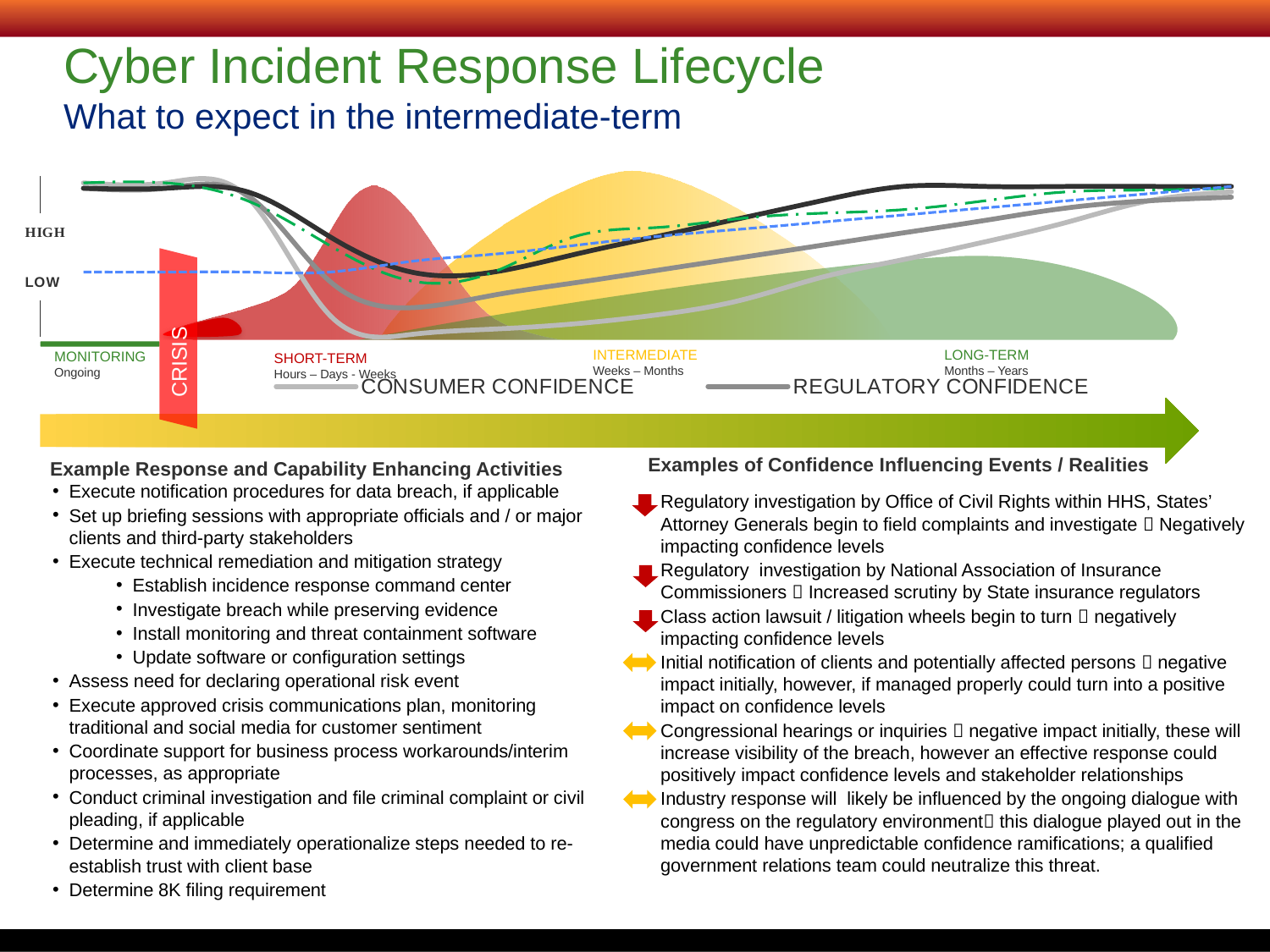
Does consumer confidence rise or fall from the Monitoring phase into the Short-term phase? fall How many phases are labeled along the horizontal axis of the chart (Monitoring, Crisis, Short-term, Intermediate, Long-term)? 5 Which phase on the horizontal axis is described as 'Ongoing'? Monitoring How many series does the chart legend list? 2 Which phase on the horizontal axis is described as lasting 'Weeks – Months'? Intermediate What are the two series named in the chart legend? Consumer Confidence and Regulatory Confidence What are the two labels shown on the vertical axis of the chart? HIGH and LOW Does regulatory confidence rise or fall from the Intermediate phase into the Long-term phase? rise What kind of chart is shown on the slide? line chart Which phase on the horizontal axis is described as lasting 'Months – Years'? Long-term